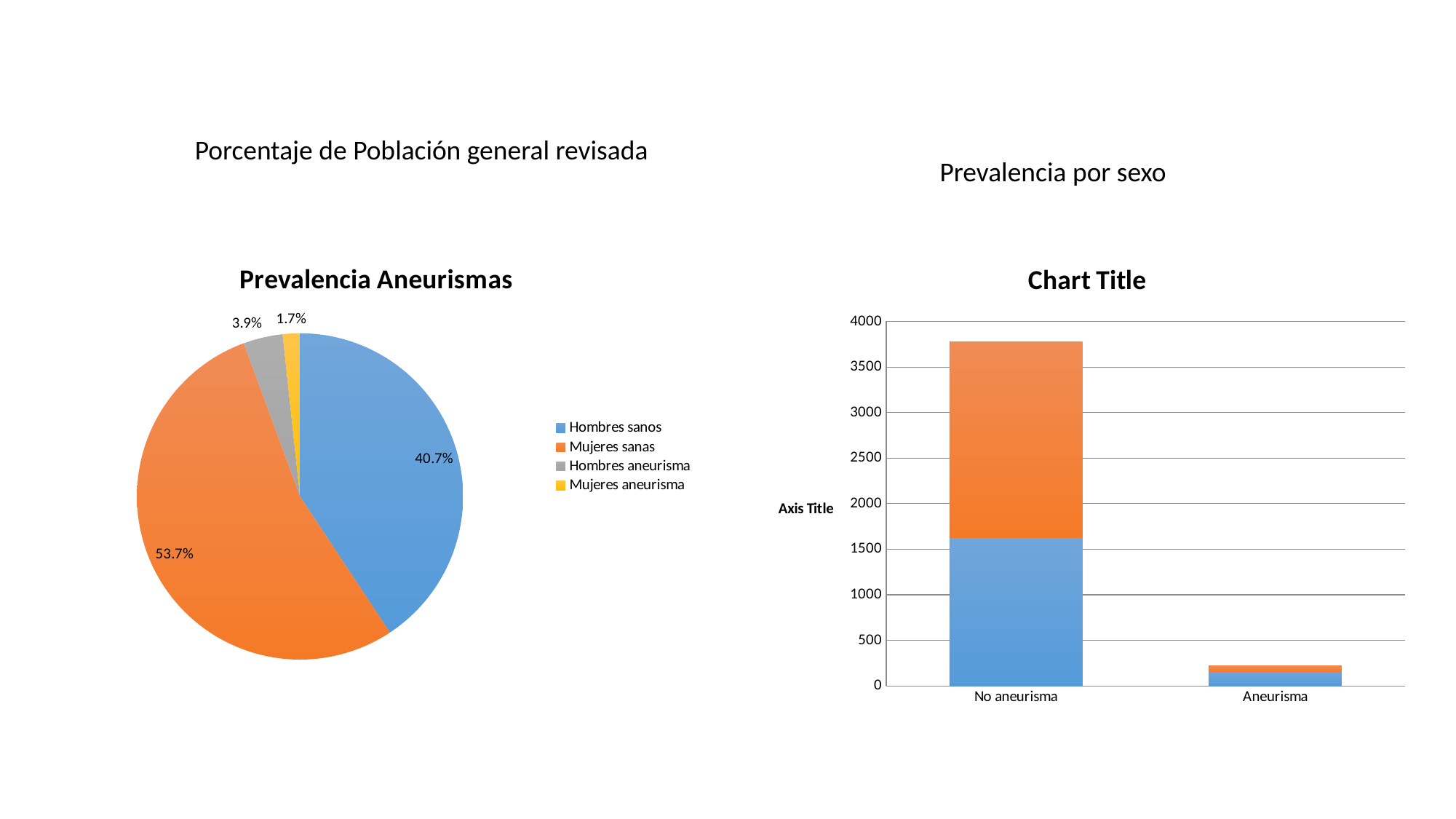
In the pie chart titled 'Prevalencia Aneurismas', which is larger: Hombres aneurisma or Mujeres aneurisma? Hombres aneurisma In the pie chart titled 'Prevalencia Aneurismas', what percentage is shown for Mujeres aneurisma? 1.7% In the chart titled 'Chart Title', how many categories are shown on the x axis? 2 What kind of chart is the chart on the left of the slide? Pie chart In the chart titled 'Chart Title', is the total height of the No aneurisma bar greater or less than 3500? greater In the pie chart titled 'Prevalencia Aneurismas', which category has the smallest slice? Mujeres aneurisma How many entries does the legend of the pie chart titled 'Prevalencia Aneurismas' list? 4 What kind of chart is the chart titled 'Chart Title' on the right of the slide? Stacked bar chart In the pie chart titled 'Prevalencia Aneurismas', which category has the largest slice? Mujeres sanas In the pie chart titled 'Prevalencia Aneurismas', what is the difference in percentage points between Mujeres sanas and Hombres sanos? 13.0 In the pie chart titled 'Prevalencia Aneurismas', what percentage is shown for Mujeres sanas? 53.7% In the pie chart titled 'Prevalencia Aneurismas', what percentage is shown for Hombres sanos? 40.7%